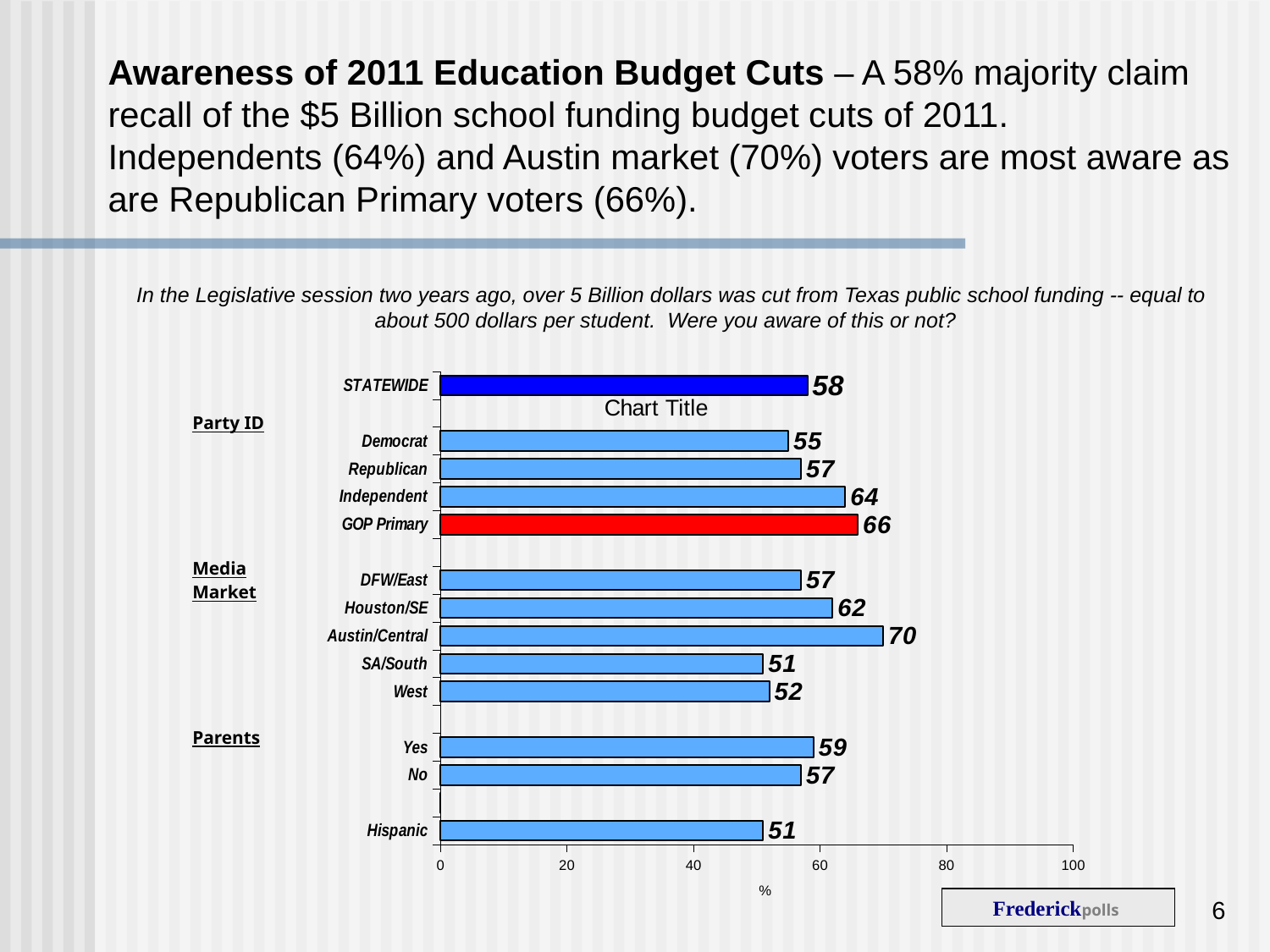
Which category has the highest value? Austin/Central What is the difference between the values for Independent and Democrat? 9 Which is larger, the value for Houston/SE or the value for DFW/East? Houston/SE What colour is the bar for GOP Primary? red What is the value for Independent? 64 What is the value for GOP Primary? 66 What is the difference between the values for Austin/Central and SA/South? 19 What is the value for Austin/Central? 70 What is the value for STATEWIDE? 58 What kind of chart is shown on the slide? bar chart Is the value for West greater or less than 60? less How many categories are plotted in the chart? 13